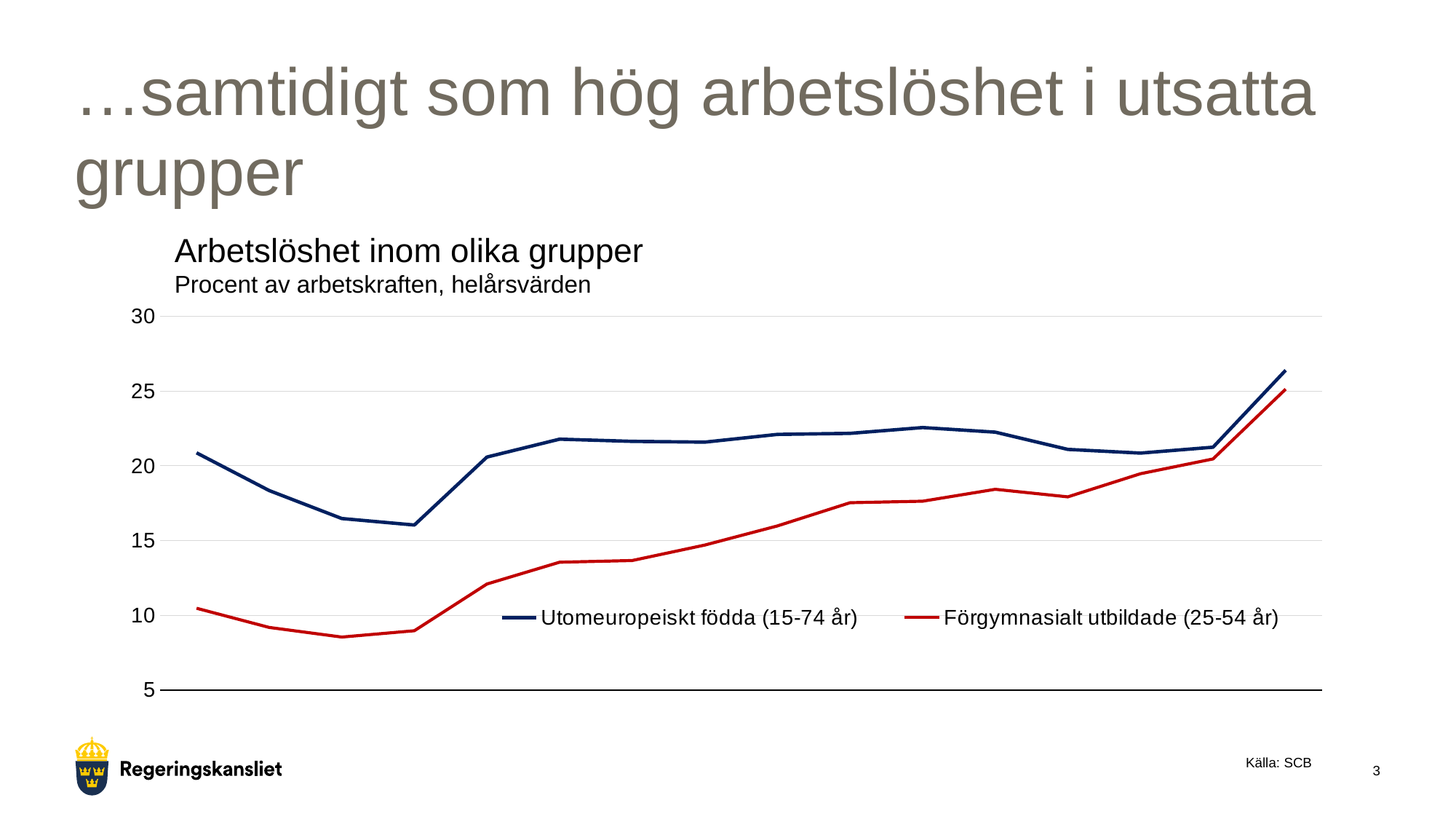
Is the final value of the Förgymnasialt utbildade (25-54 år) line greater or less than 20? greater What kind of chart is shown on the slide? line chart How many series does the legend list? 2 Which series reaches the highest value on the chart? Utomeuropeiskt födda (15-74 år) Does the Förgymnasialt utbildade (25-54 år) line overall rise or fall from left to right? rise Is the highest value of the Utomeuropeiskt födda (15-74 år) line greater or less than 25? greater Is the first value of the Utomeuropeiskt födda (15-74 år) line greater or less than 25? less What is the title of the chart? Arbetslöshet inom olika grupper Which series has the higher values throughout the chart? Utomeuropeiskt födda (15-74 år) What colour is the line for Förgymnasialt utbildade (25-54 år)? red